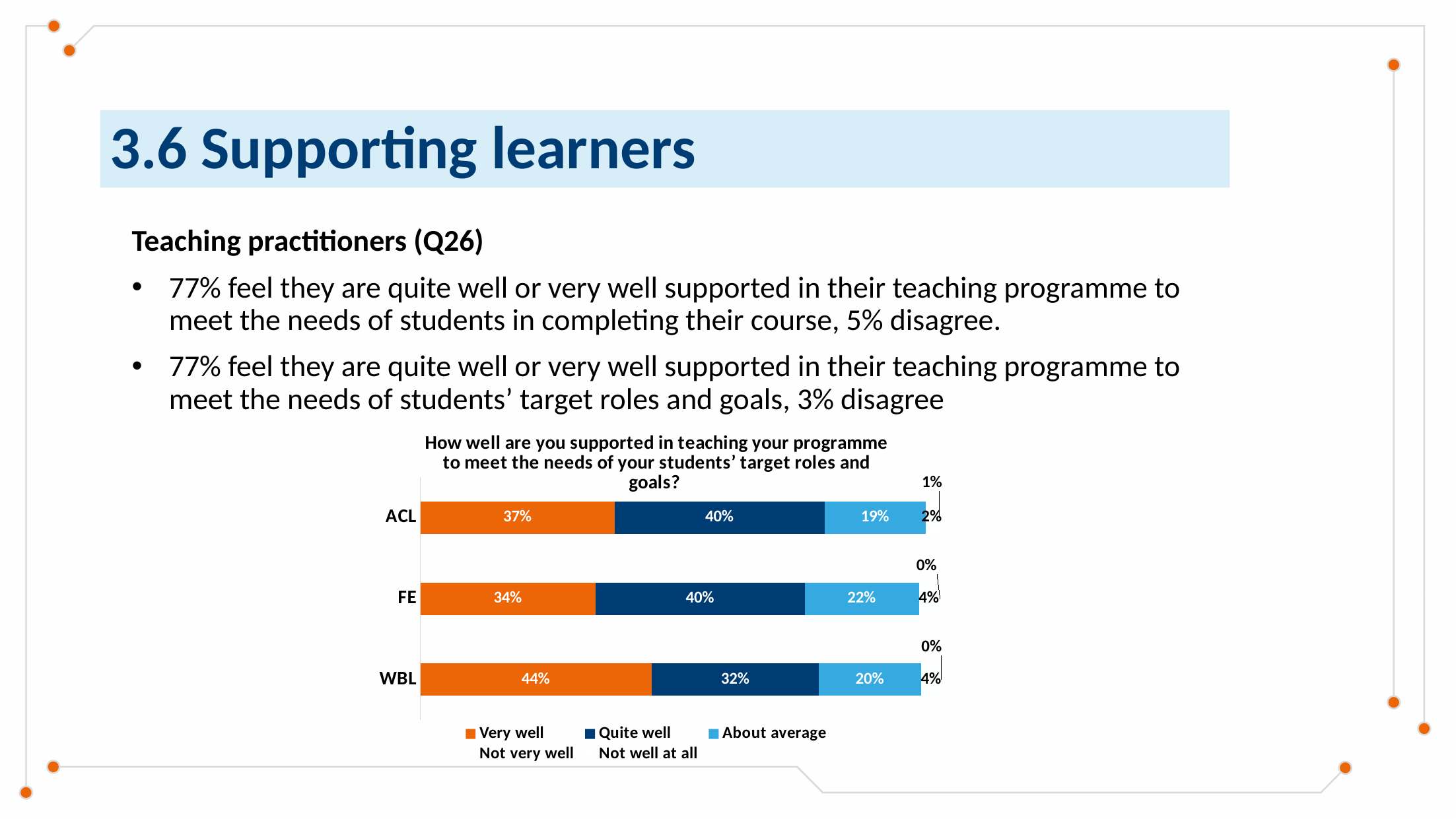
How many series does the legend list? 5 Which is larger: the 'About average' percentage for FE or for ACL? FE Which category has the highest 'Very well' percentage? WBL What type of chart is shown on the slide? Stacked bar chart What percentage of WBL respondents answered 'Very well'? 44% How many categories are shown on the chart? 3 What percentage of FE respondents answered 'About average'? 22% What percentage of WBL respondents answered 'Quite well'? 32% What percentage of ACL respondents answered 'Quite well'? 40% What colour represents 'Very well' in the chart? Orange What is the difference between the 'Very well' percentages for WBL and FE? 10% Which category has the lowest 'Very well' percentage? FE